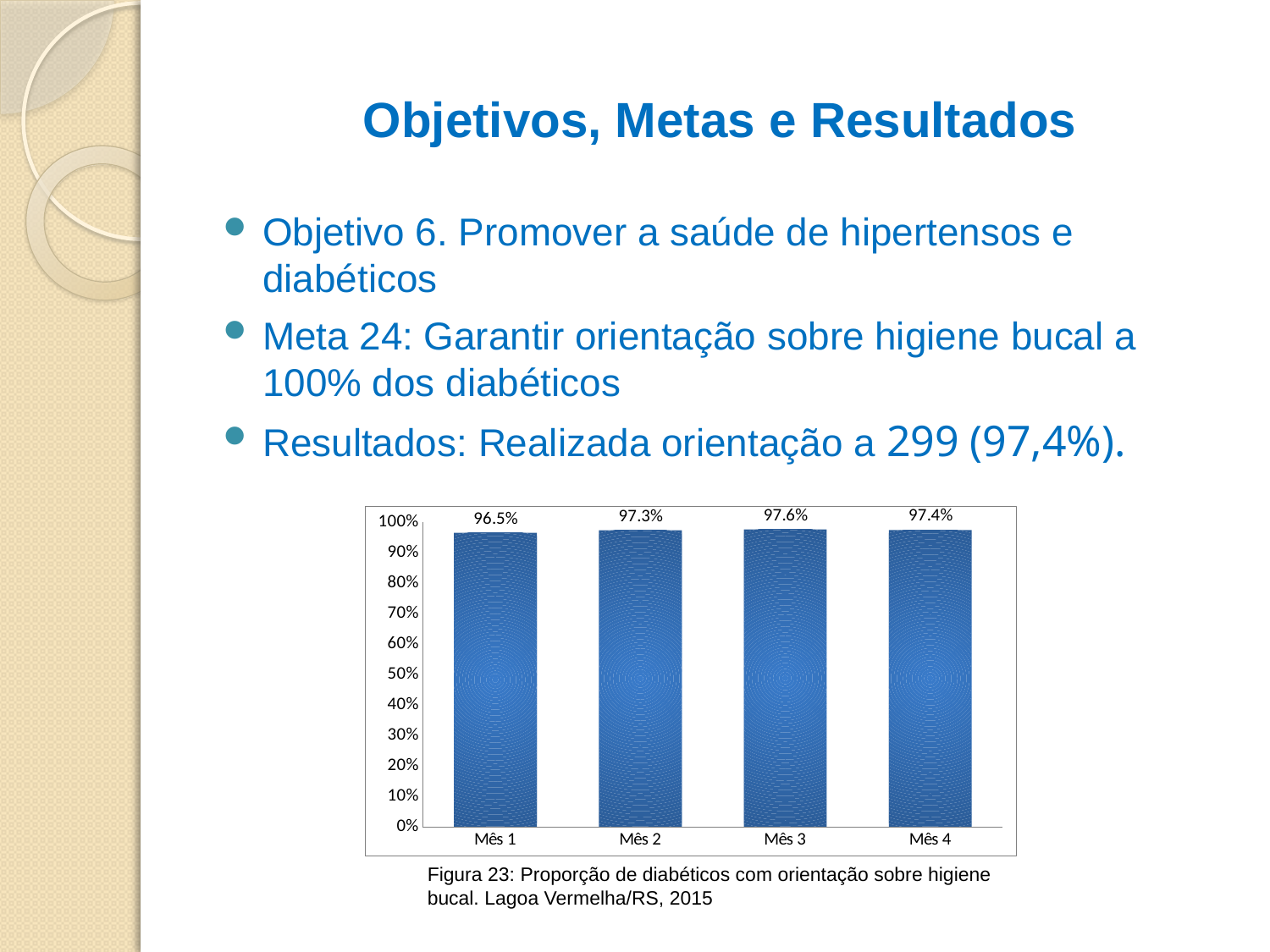
How many months are shown on the x axis? 4 Which month has the lowest value? Mês 1 What is the value for Mês 1? 96.5% What is the value for Mês 3? 97.6% Is the value for Mês 1 greater or less than 90%? greater What is the value for Mês 2? 97.3% What is the value for Mês 4? 97.4% What is the caption of the figure below the chart? Figura 23: Proporção de diabéticos com orientação sobre higiene bucal. Lagoa Vermelha/RS, 2015 Which month has the highest value? Mês 3 What kind of chart is shown on the slide? Bar chart Which is larger, the value for Mês 2 or the value for Mês 4? Mês 4 What is the difference between the values for Mês 3 and Mês 1? 1.1%